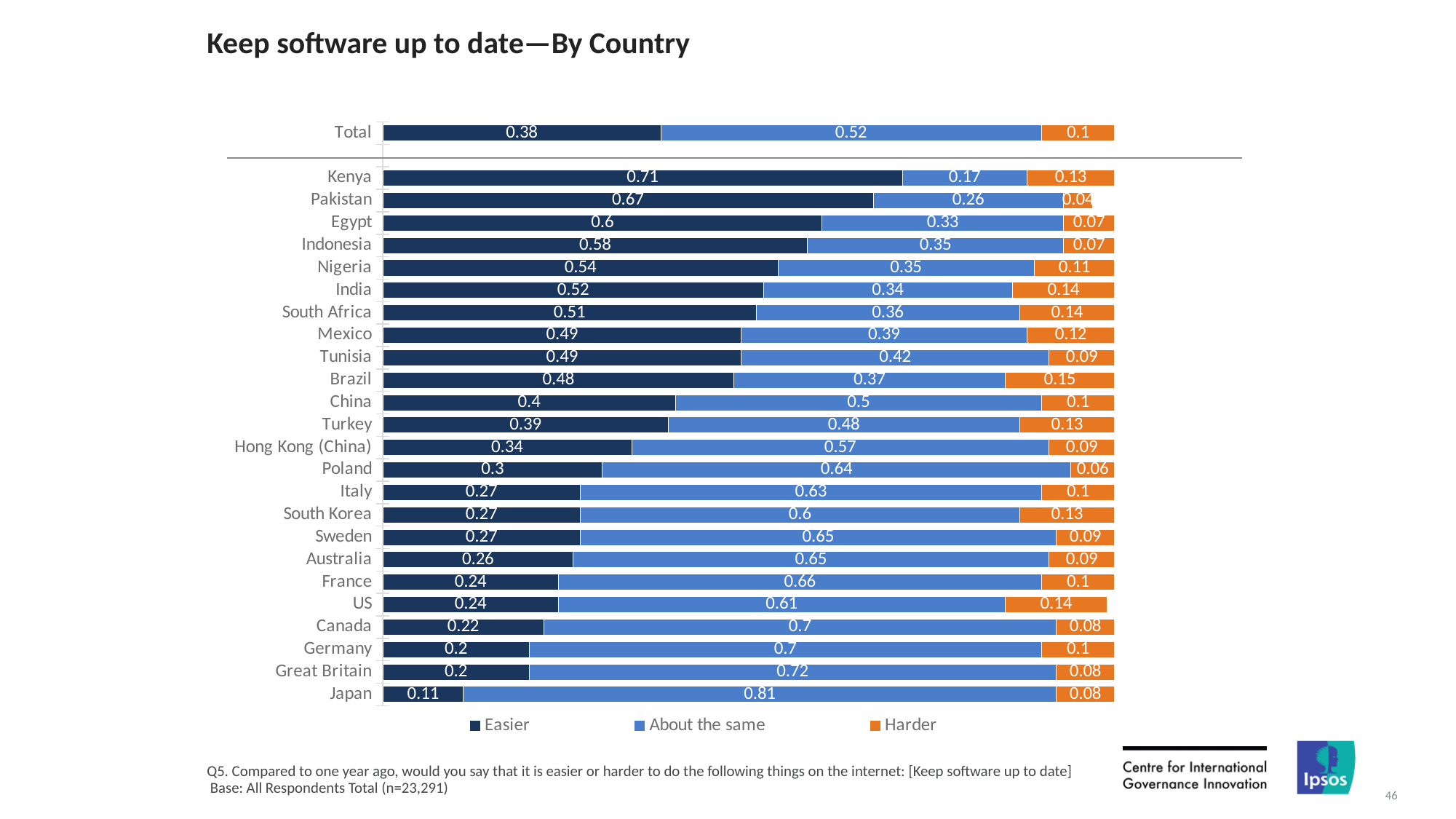
What is the title of the chart? Keep software up to date—By Country What is the 'Easier' value for Kenya? 0.71 What is the 'Easier' value for the Total row? 0.38 Which country has the lowest 'Easier' value? Japan What kind of chart is shown on the slide? Stacked bar chart What is the 'Harder' value for Brazil? 0.15 What is the total of the stacked bar for Pakistan? 0.97 What is the 'About the same' value for Japan? 0.81 Which country has the highest 'Easier' value? Kenya What is the difference between the 'Easier' values for Kenya and Japan? 0.6 How many series does the legend list? 3 Which is larger, the 'About the same' value for Canada or for Poland? Canada